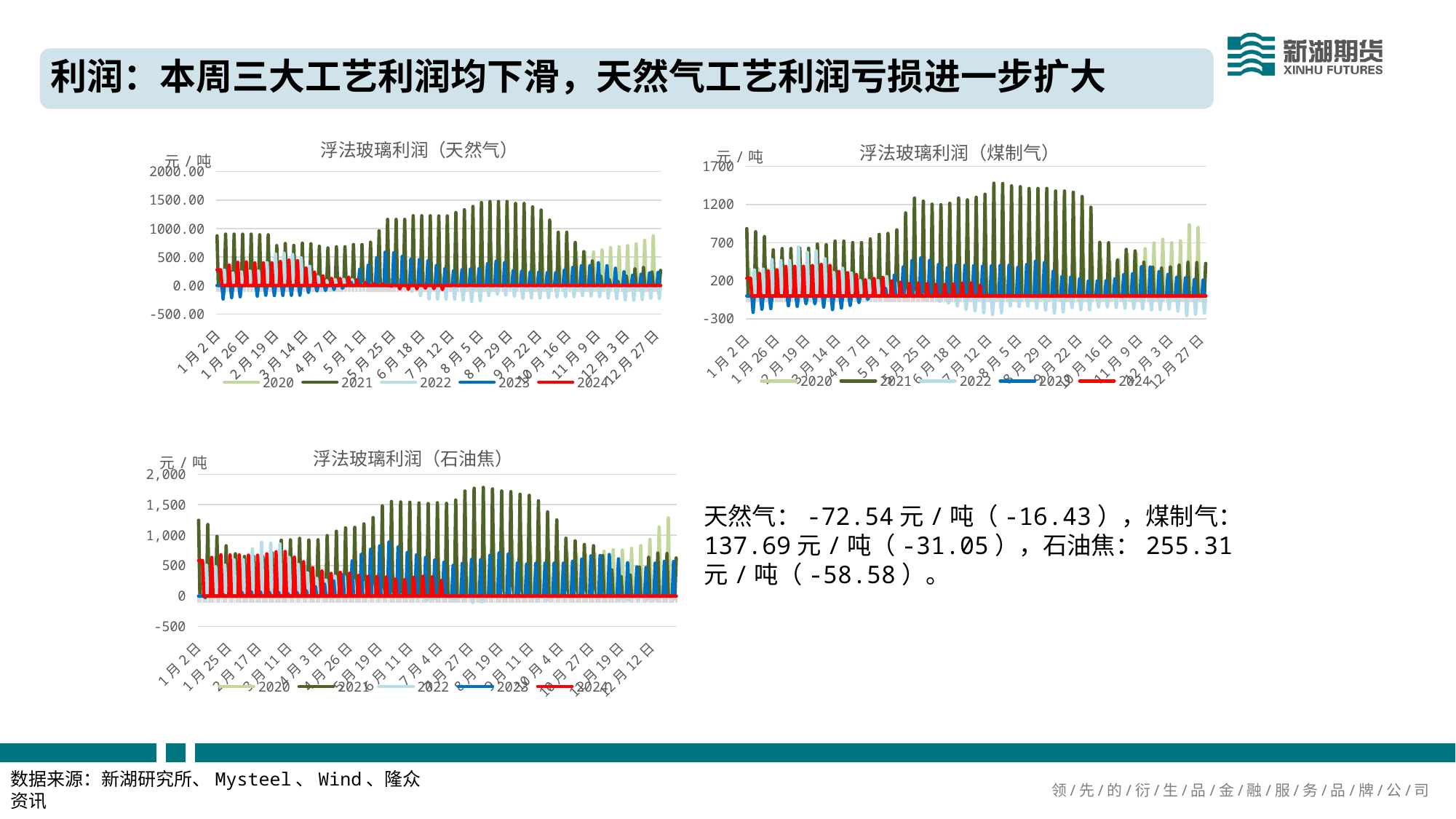
What kind of chart is the chart titled 浮法玻璃利润（石油焦）? line chart In the chart titled 浮法玻璃利润（天然气）, is the peak value of the 2021 series greater or less than 1000.00? greater What is the highest y-axis tick label on the chart titled 浮法玻璃利润（煤制气）? 1700 In the chart titled 浮法玻璃利润（石油焦）, is the peak value of the 2021 series greater or less than 1,500? greater In the chart titled 浮法玻璃利润（煤制气）, which years are listed in the legend? 2020, 2021, 2022, 2023, 2024 How many charts are shown on the slide? 3 In the chart titled 浮法玻璃利润（天然气）, does the 2024 series generally rise or fall from January to July? fall In the chart titled 浮法玻璃利润（石油焦）, is the peak value of the 2024 series greater or less than 1,000? less In the chart titled 浮法玻璃利润（天然气）, which series reaches a higher peak, 2021 or 2024? 2021 In the chart titled 浮法玻璃利润（天然气）, how many series does the legend list? 5 In the chart titled 浮法玻璃利润（石油焦）, which series reaches a higher peak, 2021 or 2023? 2021